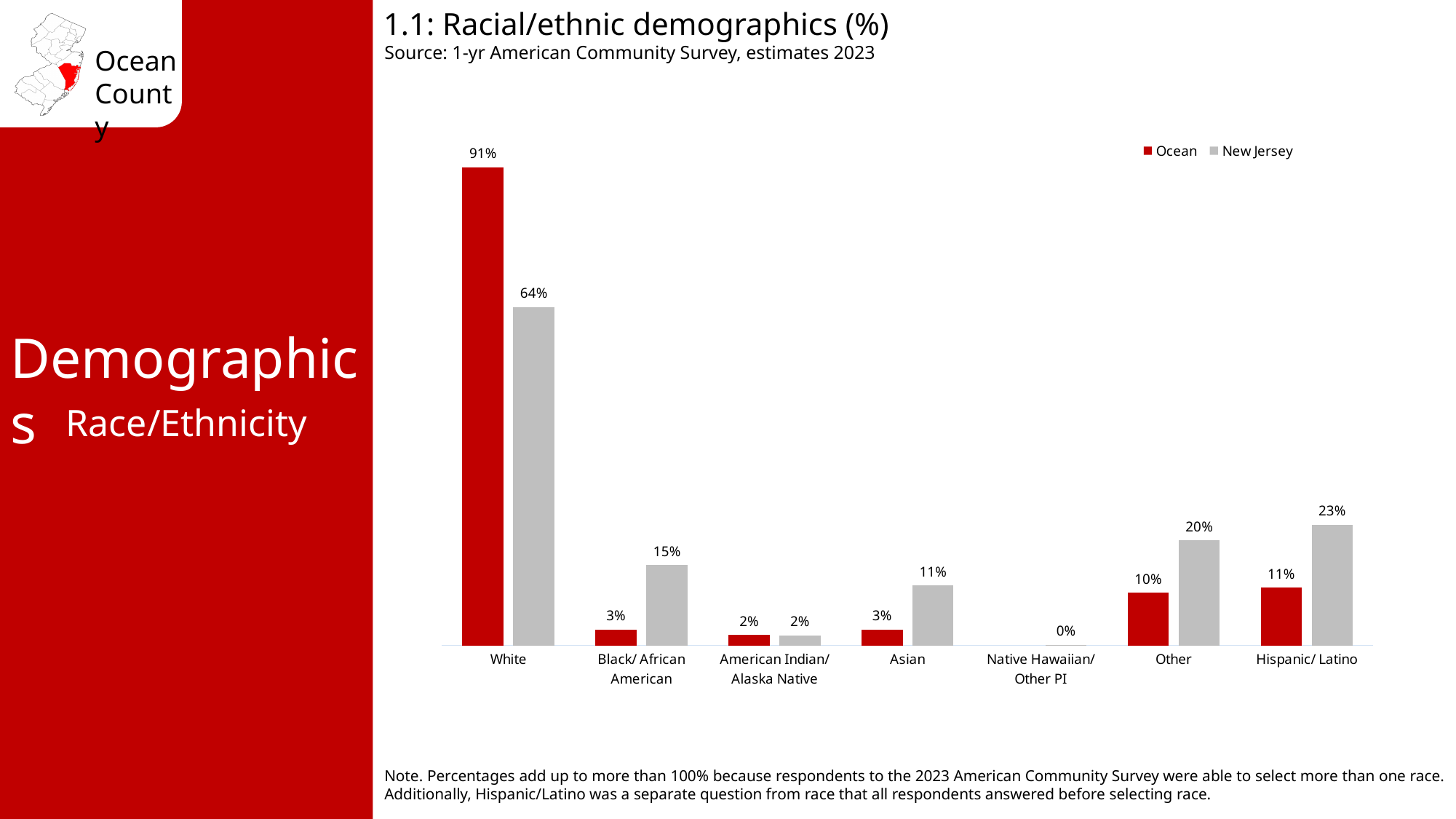
What is the New Jersey value for Black/ African American? 15% Which category has the highest Ocean value? White Which category has the lowest New Jersey value? Native Hawaiian/ Other PI How many series does the legend list? 2 What type of chart is shown? Bar chart What is the Ocean value for White? 91% What is the New Jersey value for Hispanic/ Latino? 23% What is the difference between the New Jersey and Ocean values for Asian? 8% What is the difference between the Ocean and New Jersey values for White? 27% Which is larger for Other: the Ocean value or the New Jersey value? New Jersey How many racial/ethnic categories are shown on the x axis? 7 What is the Ocean value for Other? 10%